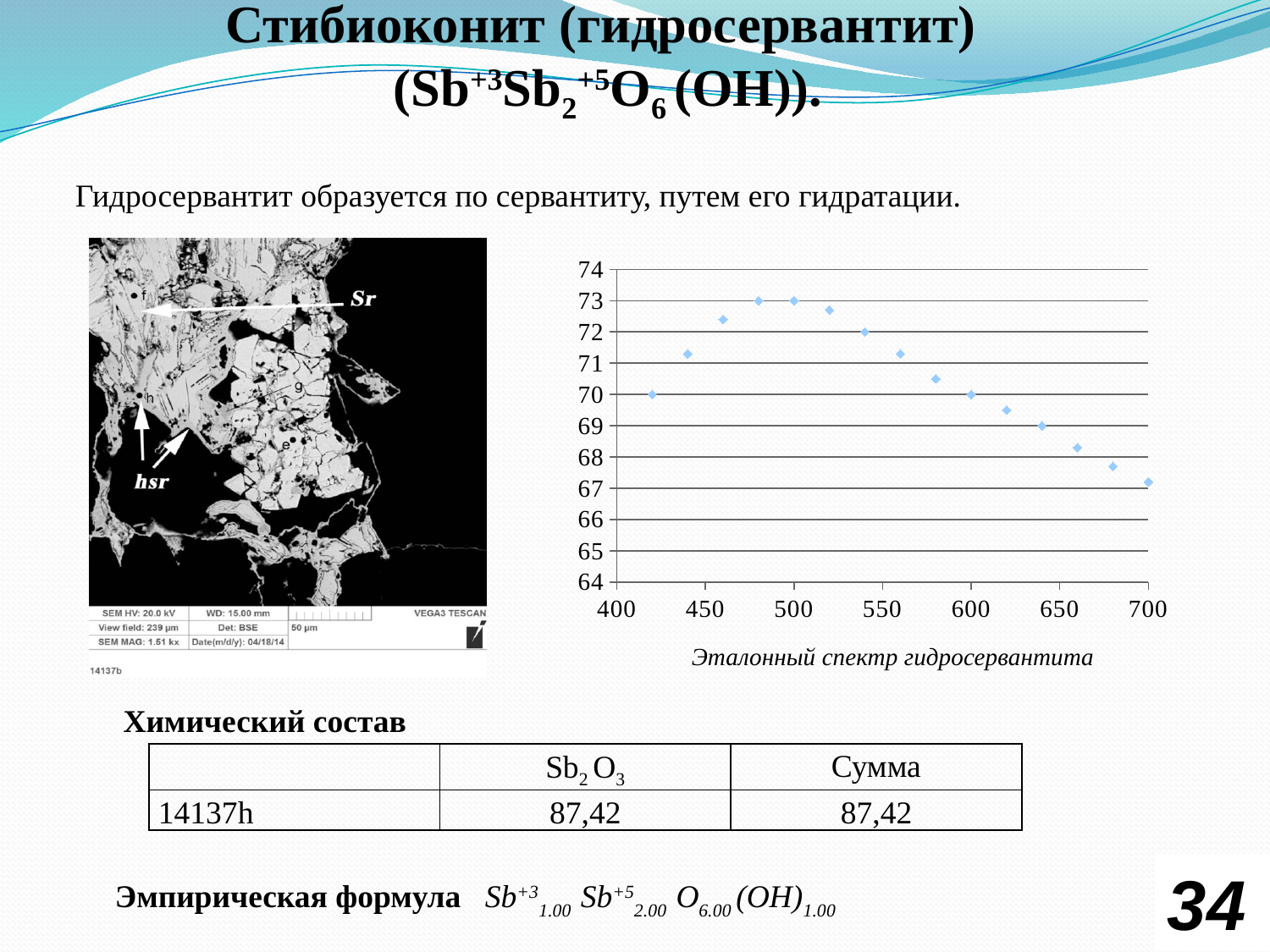
Is the value at x = 460 greater or less than 72? greater Do the values rise or fall along the x axis from 500 to 700? fall How many data points are plotted on the chart? 15 Is the value at x = 700 greater or less than 68? less What caption is written below the chart? Эталонный спектр гидросервантита What is the value plotted at x = 420? 70 At which x value is the plotted value lowest? 700 Is the value at x = 580 greater or less than 70? greater What kind of chart is shown on the slide? scatter chart What is the value plotted at x = 640? 69 Which has the larger value, the point at x = 440 or the point at x = 660? x = 440 What is the value plotted at x = 600? 70